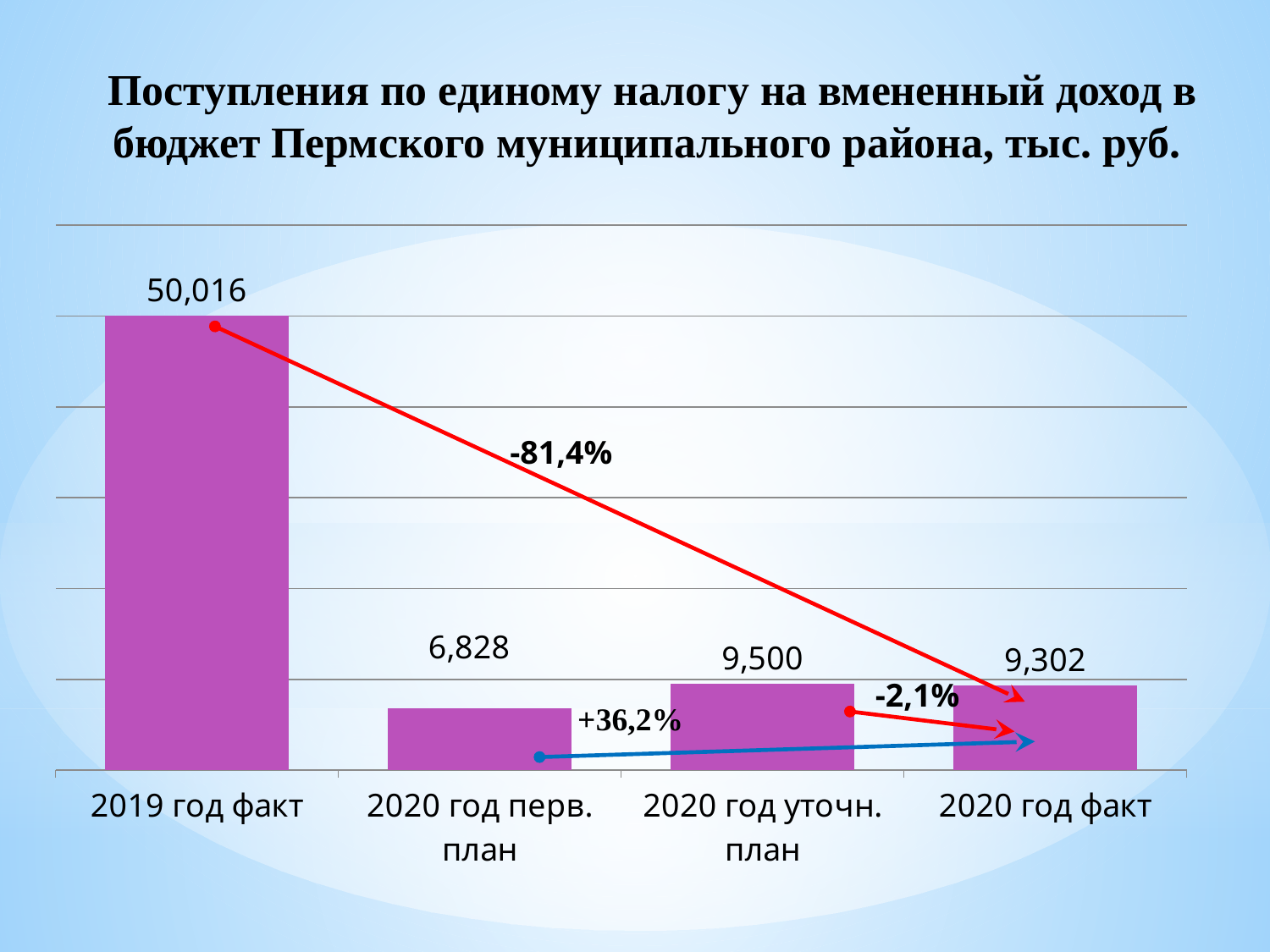
What is the difference between the values for 2020 год уточн. план and 2020 год факт? 198 What is the value for 2020 год факт? 9,302 Which is larger, the value for 2020 год уточн. план or 2020 год факт? 2020 год уточн. план What is the value for 2019 год факт? 50,016 Which category has the highest value? 2019 год факт What is the difference between the values for 2019 год факт and 2020 год факт? 40,714 What is the value for 2020 год уточн. план? 9,500 What kind of chart is shown on the slide? bar chart Which category has the lowest value? 2020 год перв. план What percentage change is annotated on the arrow from 2019 год факт to 2020 год факт? -81,4% How many categories are shown on the x axis? 4 What is the value for 2020 год перв. план? 6,828